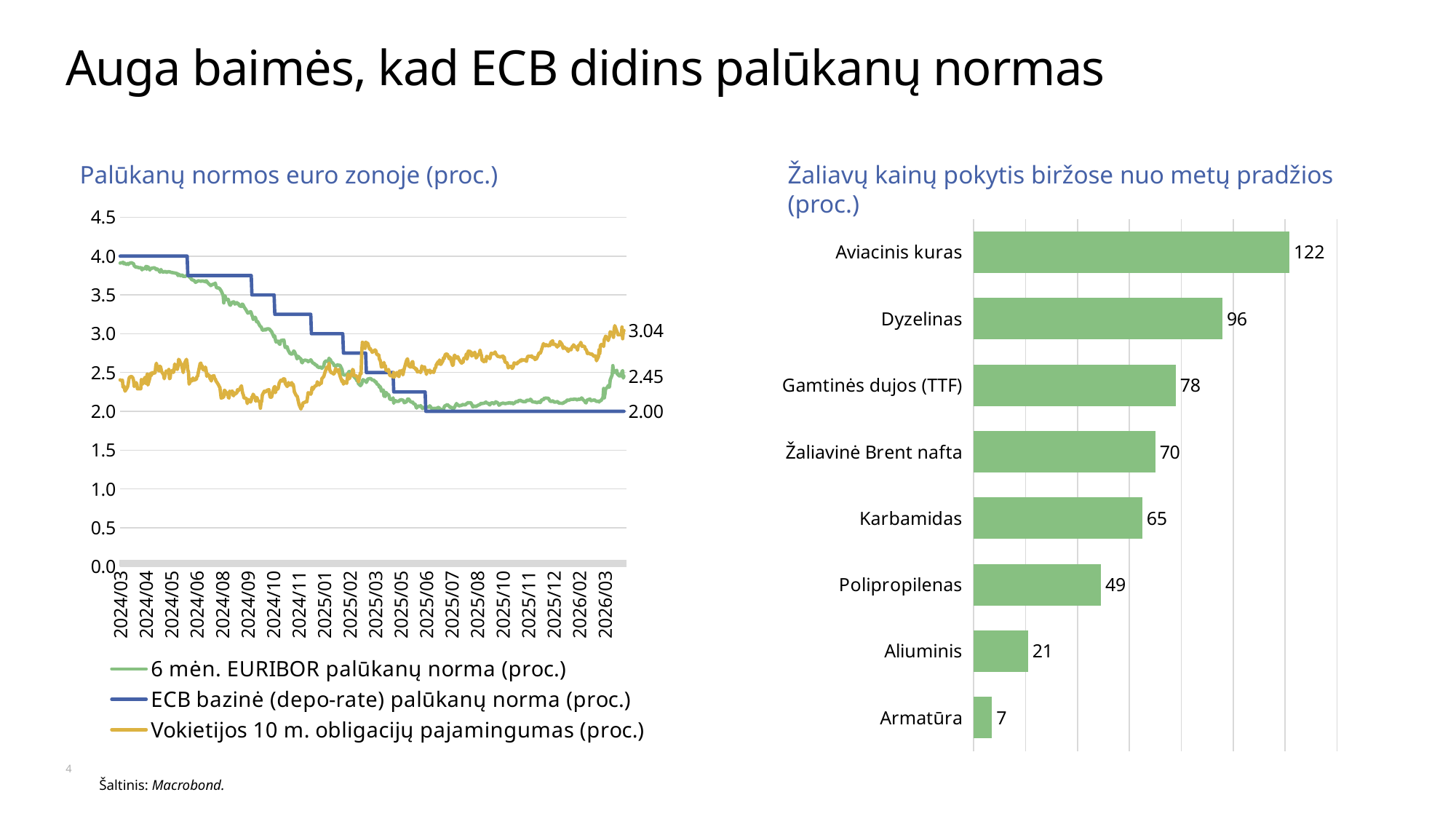
In the chart 'Žaliavų kainų pokytis biržose nuo metų pradžios (proc.)', what is the difference between the values for Dyzelinas and Gamtinės dujos (TTF)? 18 In the chart 'Žaliavų kainų pokytis biržose nuo metų pradžios (proc.)', which category has the lowest value? Armatūra In the chart 'Žaliavų kainų pokytis biržose nuo metų pradžios (proc.)', which category has the highest value? Aviacinis kuras In the chart 'Žaliavų kainų pokytis biržose nuo metų pradžios (proc.)', which is larger, the value for Polipropilenas or the value for Aliuminis? Polipropilenas In the chart 'Palūkanų normos euro zonoje (proc.)', does the ECB bazinė (depo-rate) palūkanų norma series rise or fall from 2024/03 to 2026/03? Fall What kind of chart is 'Žaliavų kainų pokytis biržose nuo metų pradžios (proc.)'? Bar chart In the chart 'Palūkanų normos euro zonoje (proc.)', what is the final labelled value of the Vokietijos 10 m. obligacijų pajamingumas series? 3.04 How many categories are shown in the chart 'Žaliavų kainų pokytis biržose nuo metų pradžios (proc.)'? 8 How many series does the legend of the chart 'Palūkanų normos euro zonoje (proc.)' list? 3 In the chart 'Palūkanų normos euro zonoje (proc.)', what is the final labelled value of the ECB bazinė (depo-rate) palūkanų norma series? 2.00 In the chart 'Žaliavų kainų pokytis biržose nuo metų pradžios (proc.)', what is the value for Karbamidas? 65 In the chart 'Žaliavų kainų pokytis biržose nuo metų pradžios (proc.)', what is the value for Aviacinis kuras? 122